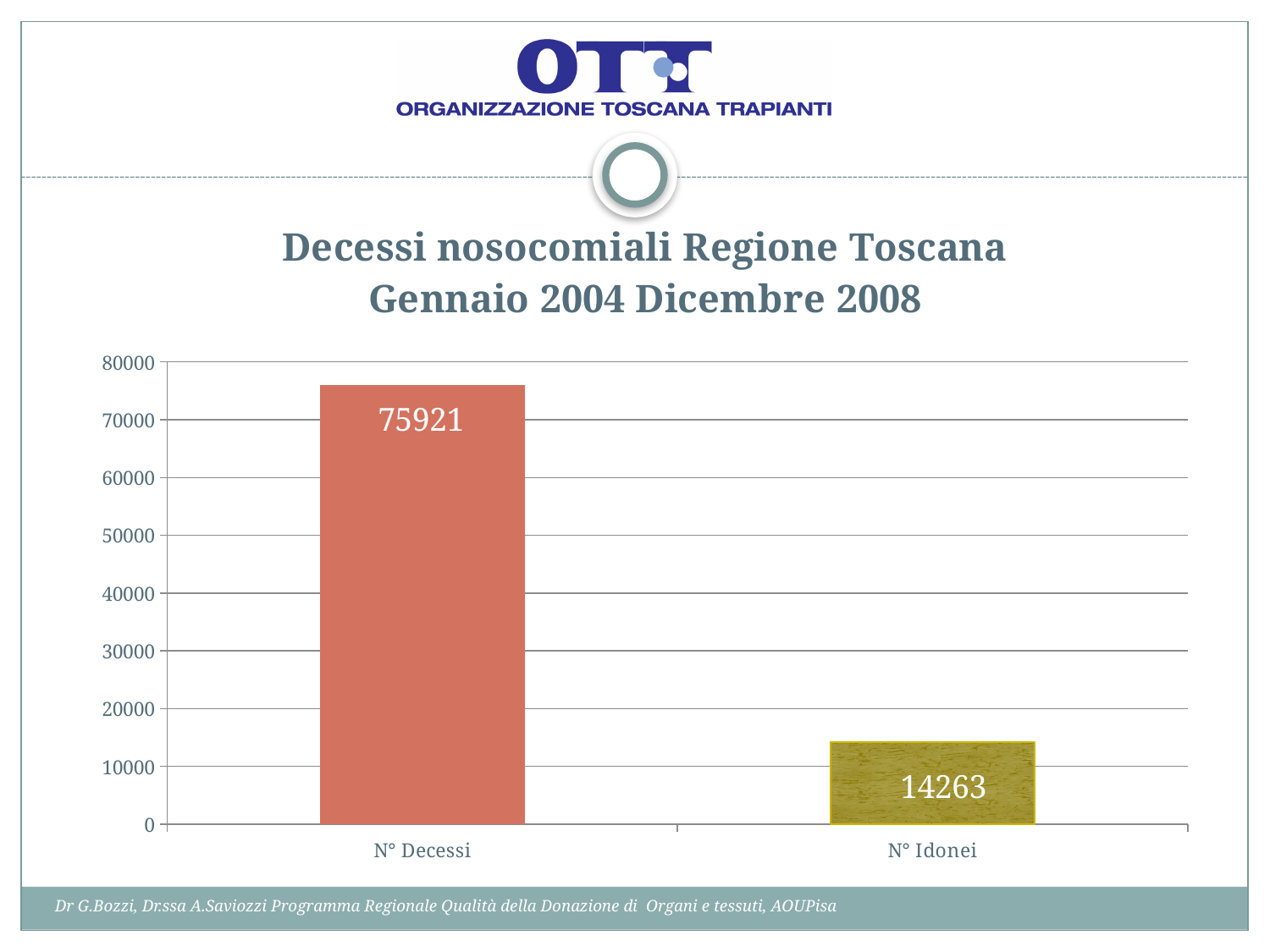
What is the value for N° Idonei? 14263 What is the maximum value shown on the vertical axis? 80000 What is the difference between N° Decessi and N° Idonei? 61658 What is the value for N° Decessi? 75921 What is the title of the chart? Decessi nosocomiali Regione Toscana Gennaio 2004 Dicembre 2008 Which category has the highest value? N° Decessi Is the value for N° Idonei greater or less than 20000? less How many categories are shown in the chart? 2 Is the value for N° Decessi greater or less than 70000? greater What kind of chart is shown on the slide? bar chart Which is larger, N° Decessi or N° Idonei? N° Decessi Which category has the lowest value? N° Idonei